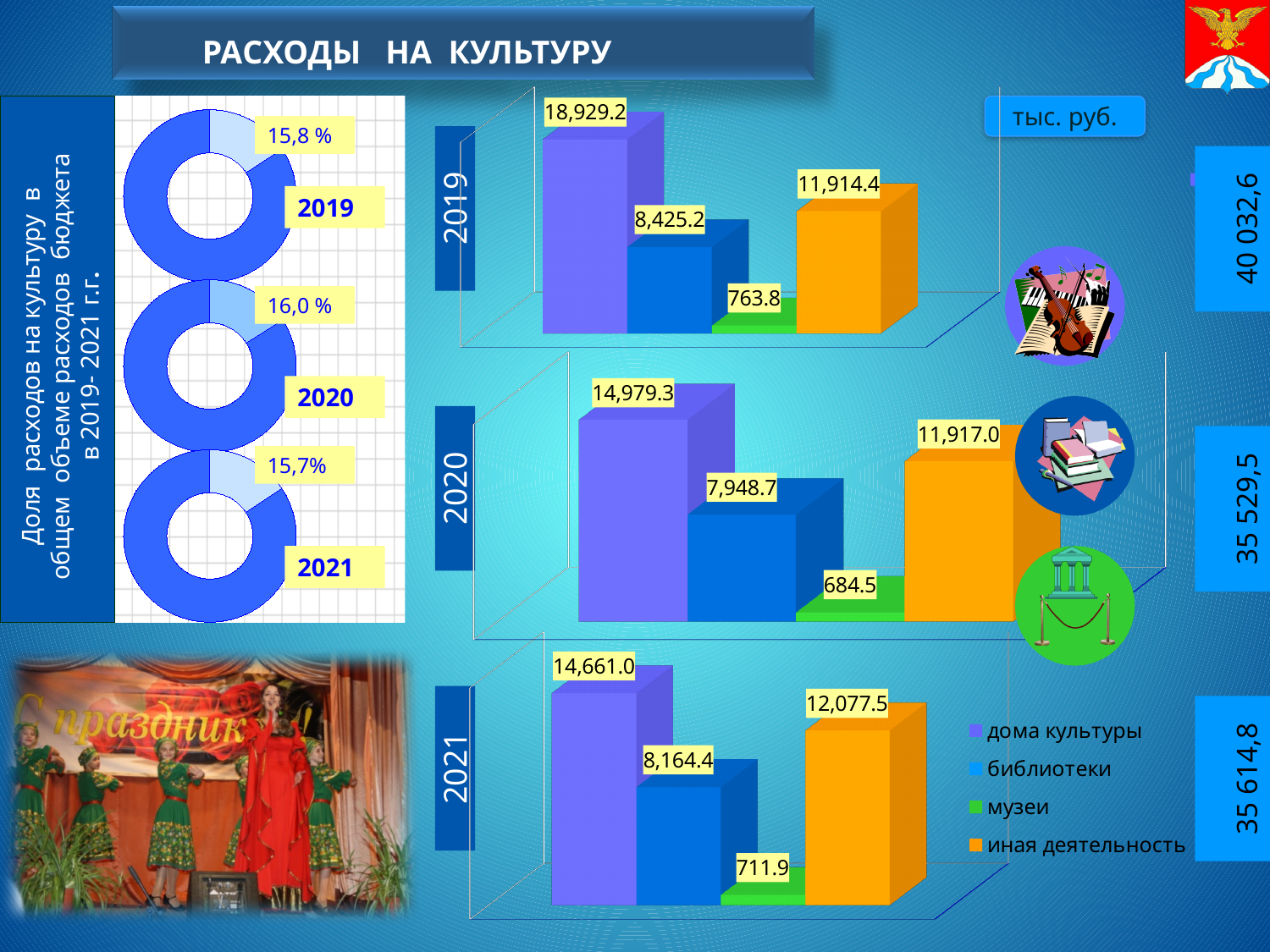
In the 2020 bar chart, what is the value for библиотеки? 7,948.7 In the 2019 bar chart, what is the value for дома культуры? 18,929.2 In the 2021 bar chart, what is the value for иная деятельность? 12,077.5 In the 2020 bar chart, which is larger: библиотеки or иная деятельность? иная деятельность What kind of chart is used to show the 2019, 2020 and 2021 expenditure breakdowns? bar chart Across the donut charts, which year has the lowest share of culture expenditure? 2021 What unit is indicated for the bar chart values? тыс. руб. In the 2021 bar chart, which category has the lowest value? музеи In the donut chart for 2020, what share of total budget expenditure goes to culture? 16,0 % In the 2020 bar chart, which category has the highest value? дома культуры In the 2019 bar chart, what is the difference between дома культуры and иная деятельность? 7,014.8 How many categories does the legend of the bar charts list? 4